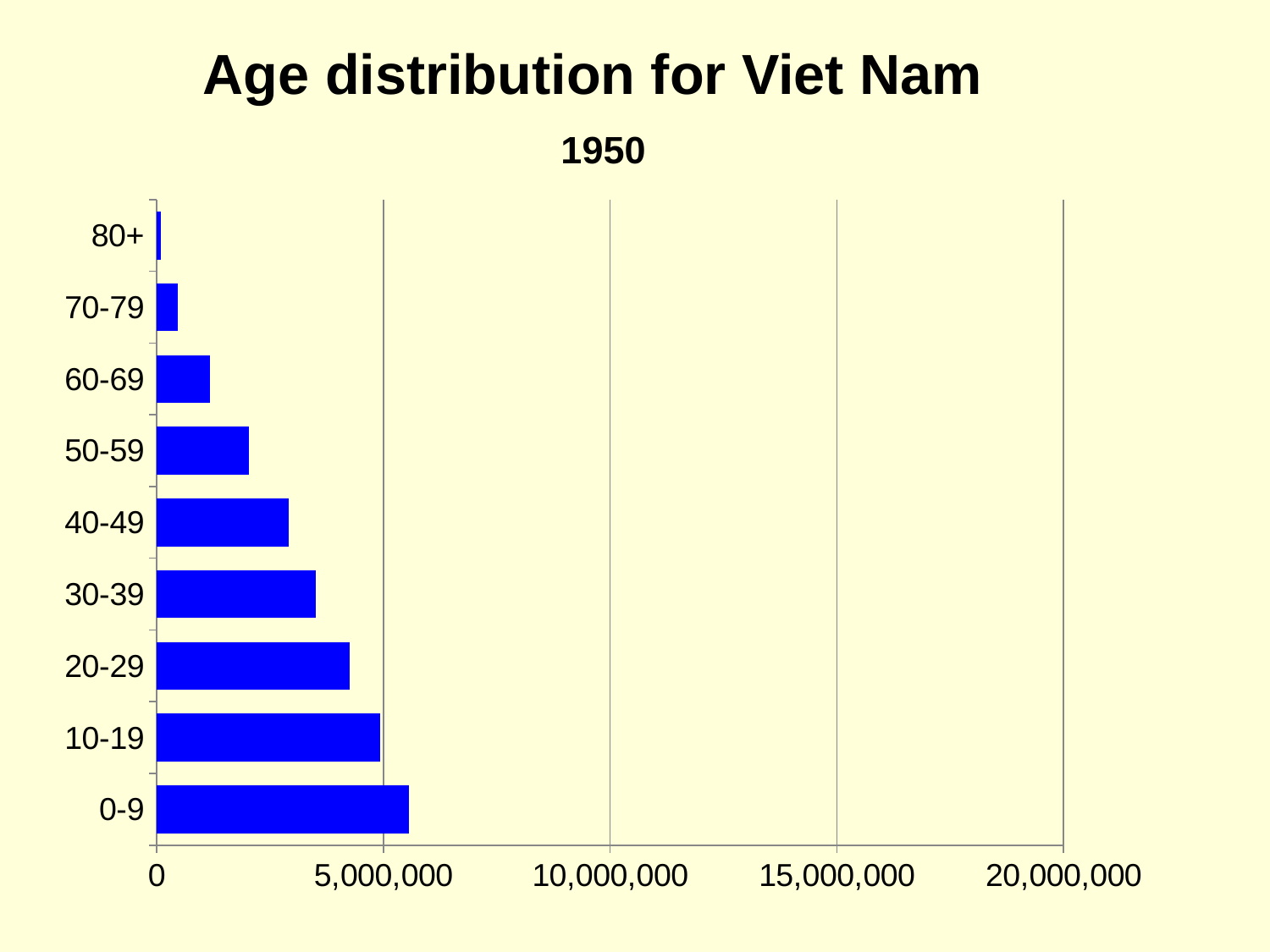
What is the title of the chart? 1950 What kind of chart is shown on the slide? bar chart Which age group has a larger value, 30-39 or 50-59? 30-39 Is the value for the 60-69 age group greater or less than 5,000,000? less Do the bars get longer or shorter as the age groups get older? shorter Which age group has a larger value, 70-79 or 40-49? 40-49 Which age group has the highest value? 0-9 Is the value for the 0-9 age group greater or less than 5,000,000? greater What year does the chart show data for? 1950 How many age groups are shown in the chart? 9 Which age group has the lowest value? 80+ Is the value for the 20-29 age group greater or less than 5,000,000? less